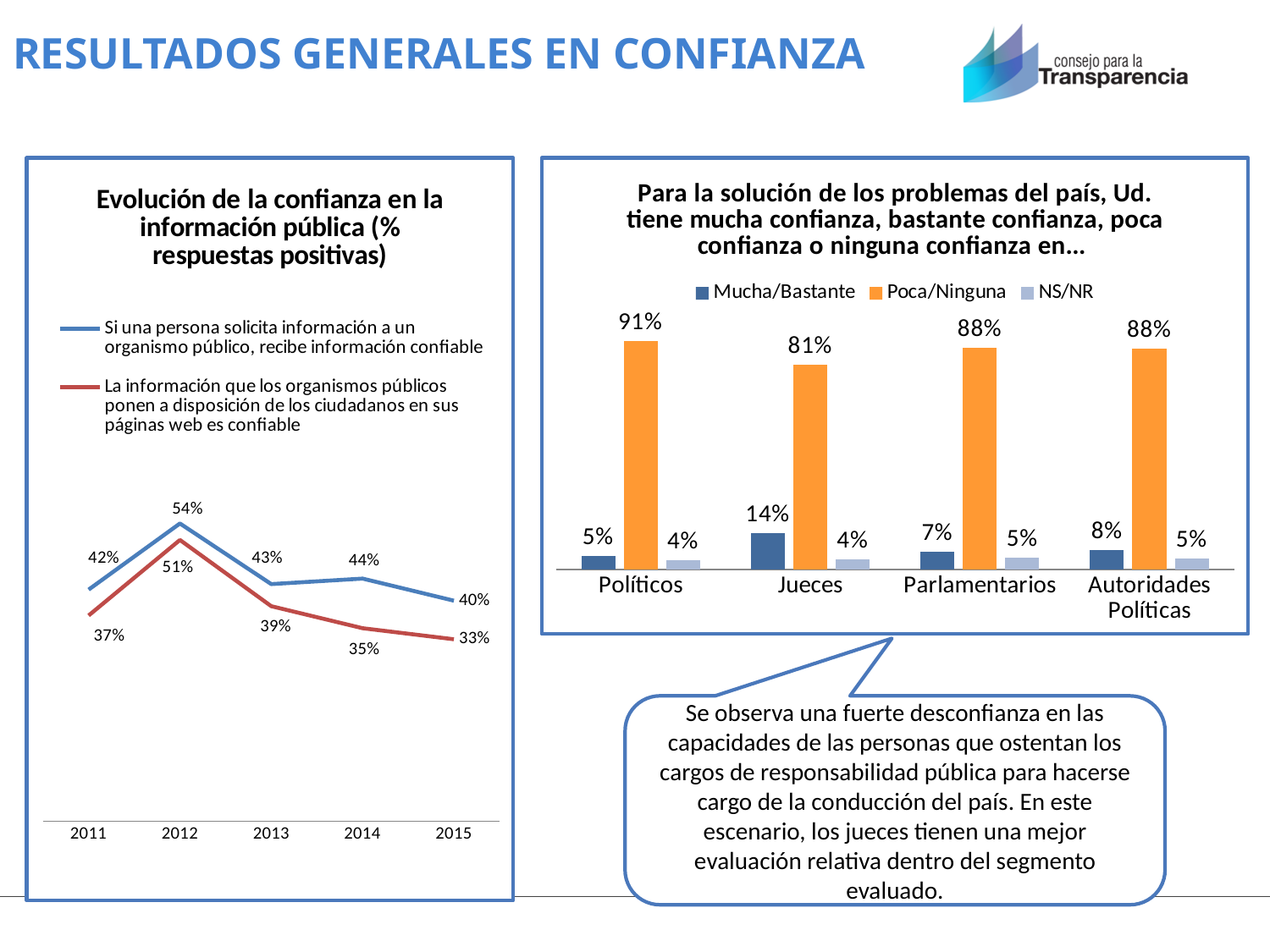
In the left chart (Evolución de la confianza en la información pública), what is the value of the red series (La información que los organismos públicos ponen a disposición de los ciudadanos en sus páginas web es confiable) in 2015? 33% In the left chart (Evolución de la confianza en la información pública), does the red series rise or fall from 2012 to 2015? fall In the right chart (Para la solución de los problemas del país...), how many series does the legend list? 3 In the right chart (Para la solución de los problemas del país...), which category has the highest Poca/Ninguna value? Políticos In the left chart (Evolución de la confianza en la información pública), what is the value of the blue series (Si una persona solicita información a un organismo público, recibe información confiable) in 2012? 54% In the right chart (Para la solución de los problemas del país...), what is the difference between the Poca/Ninguna values for Políticos and Jueces? 10% In the left chart (Evolución de la confianza en la información pública), in which year does the red series reach its lowest value? 2015 In the left chart (Evolución de la confianza en la información pública), what is the difference between the blue and red series in 2014? 9% What kind of chart is the left chart (Evolución de la confianza en la información pública)? line chart In the right chart (Para la solución de los problemas del país...), what is the Poca/Ninguna value for Jueces? 81% In the left chart (Evolución de la confianza en la información pública), how many years are shown on the x axis? 5 In the right chart (Para la solución de los problemas del país...), which category has the highest Mucha/Bastante value? Jueces